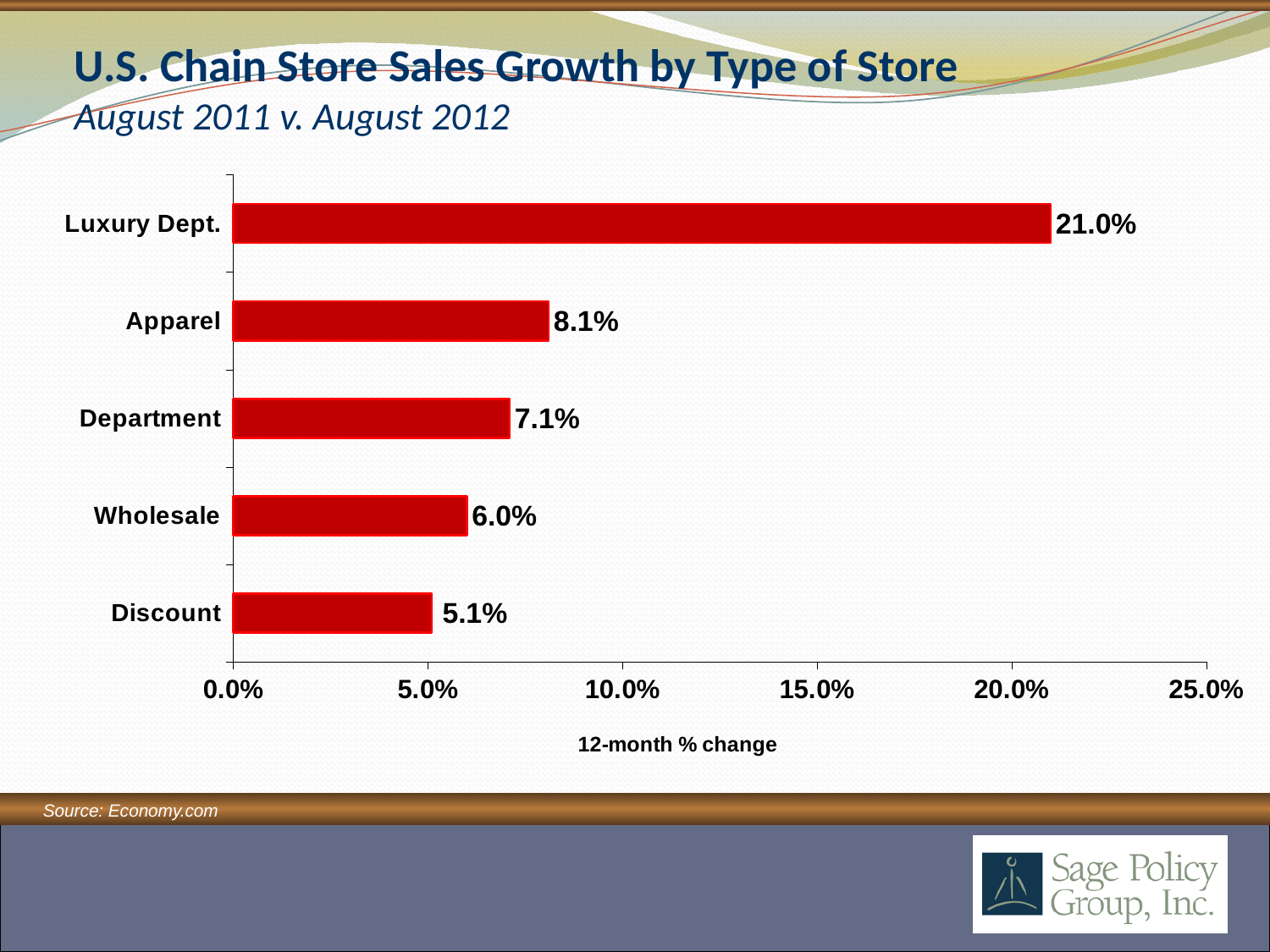
What is the difference in sales growth between Department and Discount stores? 2.0% What is the 12-month % change for Apparel stores? 8.1% What is the 12-month % change for Discount stores? 5.1% What is the 12-month % change for Luxury Dept. stores? 21.0% Which has higher sales growth, Apparel or Department stores? Apparel How many types of store are shown in the chart? 5 What kind of chart is shown on the slide? Bar chart Which type of store has the highest sales growth? Luxury Dept. What is the 12-month % change for Wholesale stores? 6.0% Which type of store has the lowest sales growth? Discount What is the difference in sales growth between Luxury Dept. and Apparel stores? 12.9% What is the label of the horizontal axis? 12-month % change